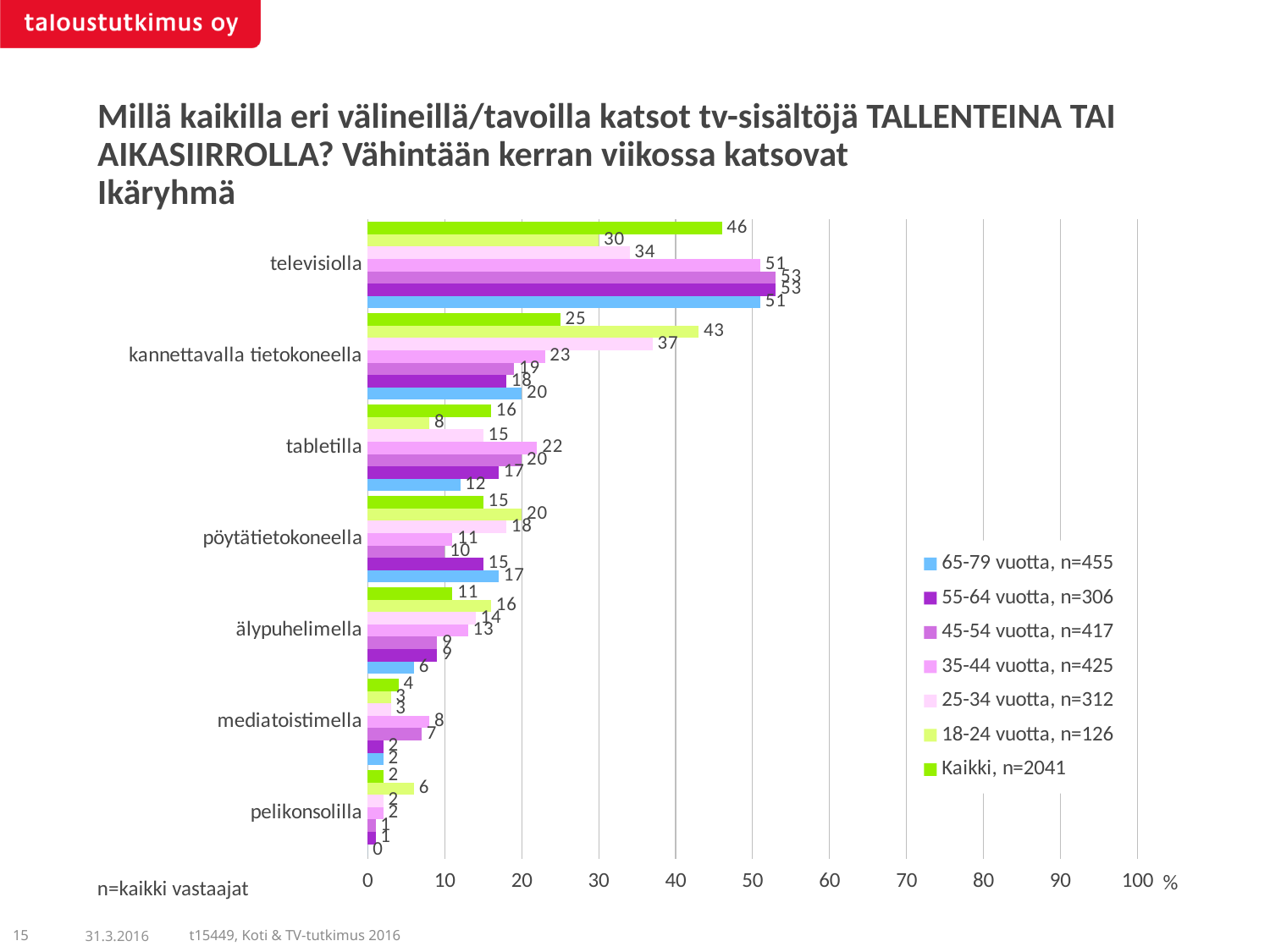
What is the value for Kaikki, n=2041 for televisiolla? 46 Which device category has the highest value for Kaikki, n=2041? televisiolla Which age group has the lowest value for televisiolla? 18-24 vuotta, n=126 How many device categories are shown on the chart? 7 Is the value for 45-54 vuotta, n=417 for televisiolla greater or less than 50? greater How many series does the legend list? 7 What is the value for 18-24 vuotta, n=126 for kannettavalla tietokoneella? 43 What is the difference between the 18-24 vuotta, n=126 value and the Kaikki, n=2041 value for kannettavalla tietokoneella? 18 What kind of chart is shown on the slide? bar chart What is the value for 65-79 vuotta, n=455 for pelikonsolilla? 0 What is the value for 35-44 vuotta, n=425 for tabletilla? 22 For älypuhelimella, which is larger: the value for 18-24 vuotta, n=126 or the value for 65-79 vuotta, n=455? 18-24 vuotta, n=126